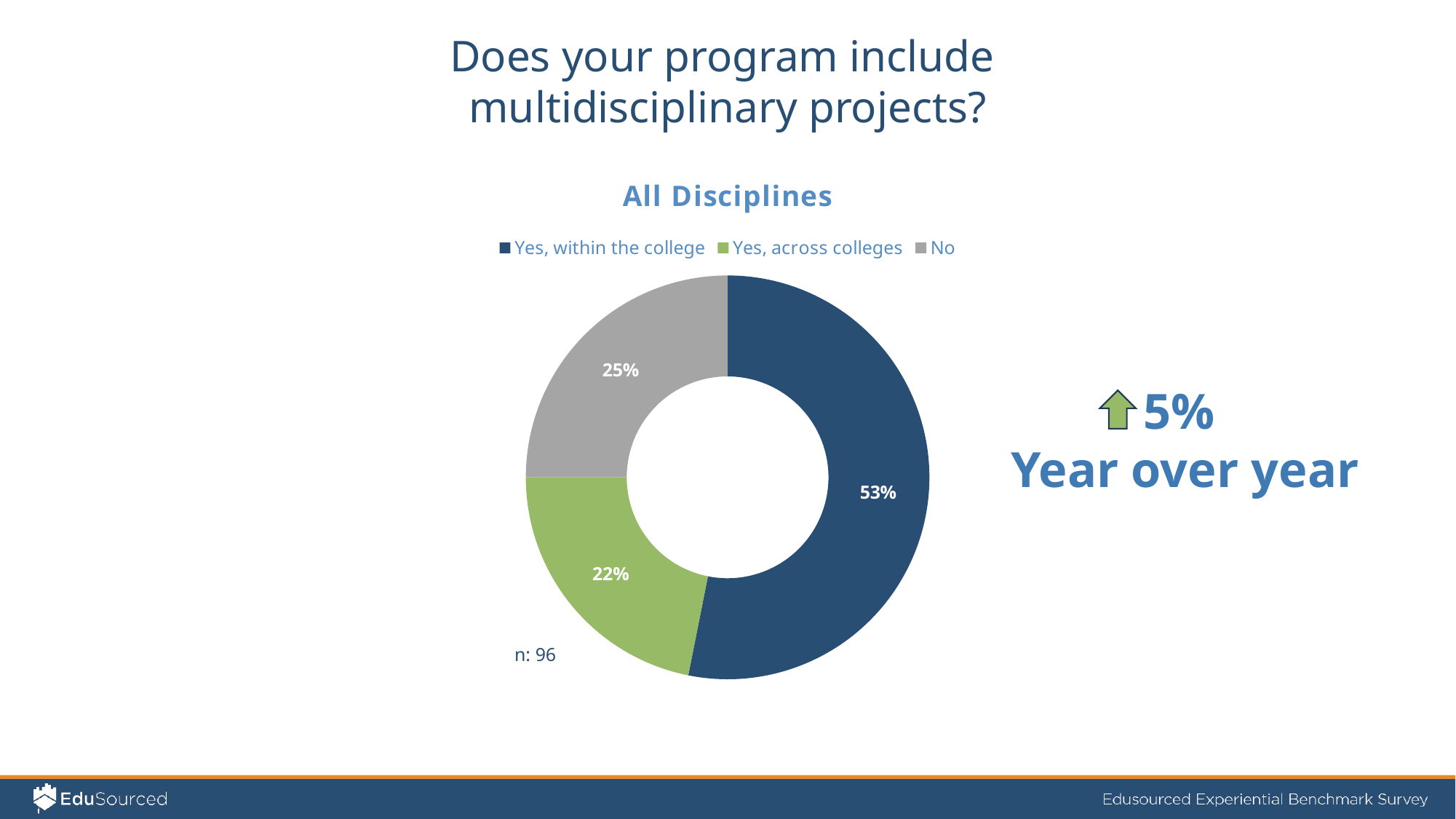
What percentage of respondents answered "Yes, within the college"? 53% What is the title of the chart? All Disciplines What kind of chart is shown on the slide? Pie chart (donut) What percentage of respondents answered "No"? 25% How many categories does the chart show? 3 Which response has the smallest share of the chart? Yes, across colleges What is the sample size (n) shown for the chart? 96 What percentage of respondents answered "Yes, across colleges"? 22% What is the difference in percentage points between "Yes, within the college" and "No"? 28 What is the combined share of the two "Yes" responses? 75% Which is larger, the share for "No" or the share for "Yes, across colleges"? No Which response has the largest share of the chart? Yes, within the college